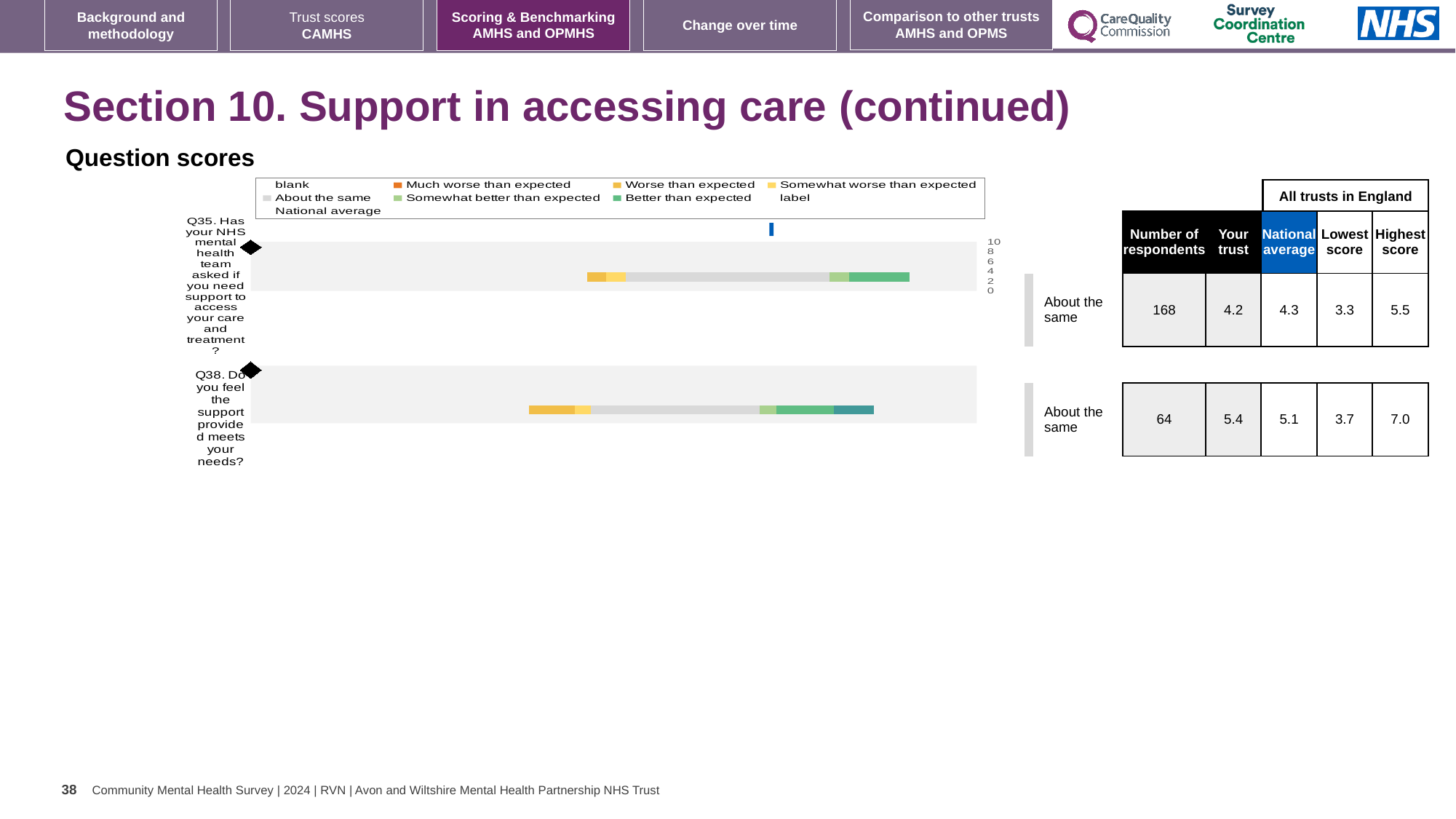
How many questions (categories) are plotted in the question scores chart? 2 How many entries does the legend of the question scores chart list? 9 In the table beside the chart, what is the 'Your trust' score for Q38? 5.4 What benchmark category is shown next to the bar for Q35 in the question scores chart? About the same In the table beside the chart, what is the national average for Q38? 5.1 In the table beside the chart, how many respondents answered Q35? 168 Which question has the higher 'Your trust' score in the table, Q35 or Q38? Q38 What kind of chart is used to show the question scores on this slide? bar chart In the table beside the chart, what is the highest score among all trusts in England for Q38? 7.0 In the table beside the chart, what is the 'Your trust' score for Q35? 4.2 What is the difference between the highest score and the lowest score for Q35 in the table? 2.2 Which legend entry in the question scores chart is shown in light grey? About the same